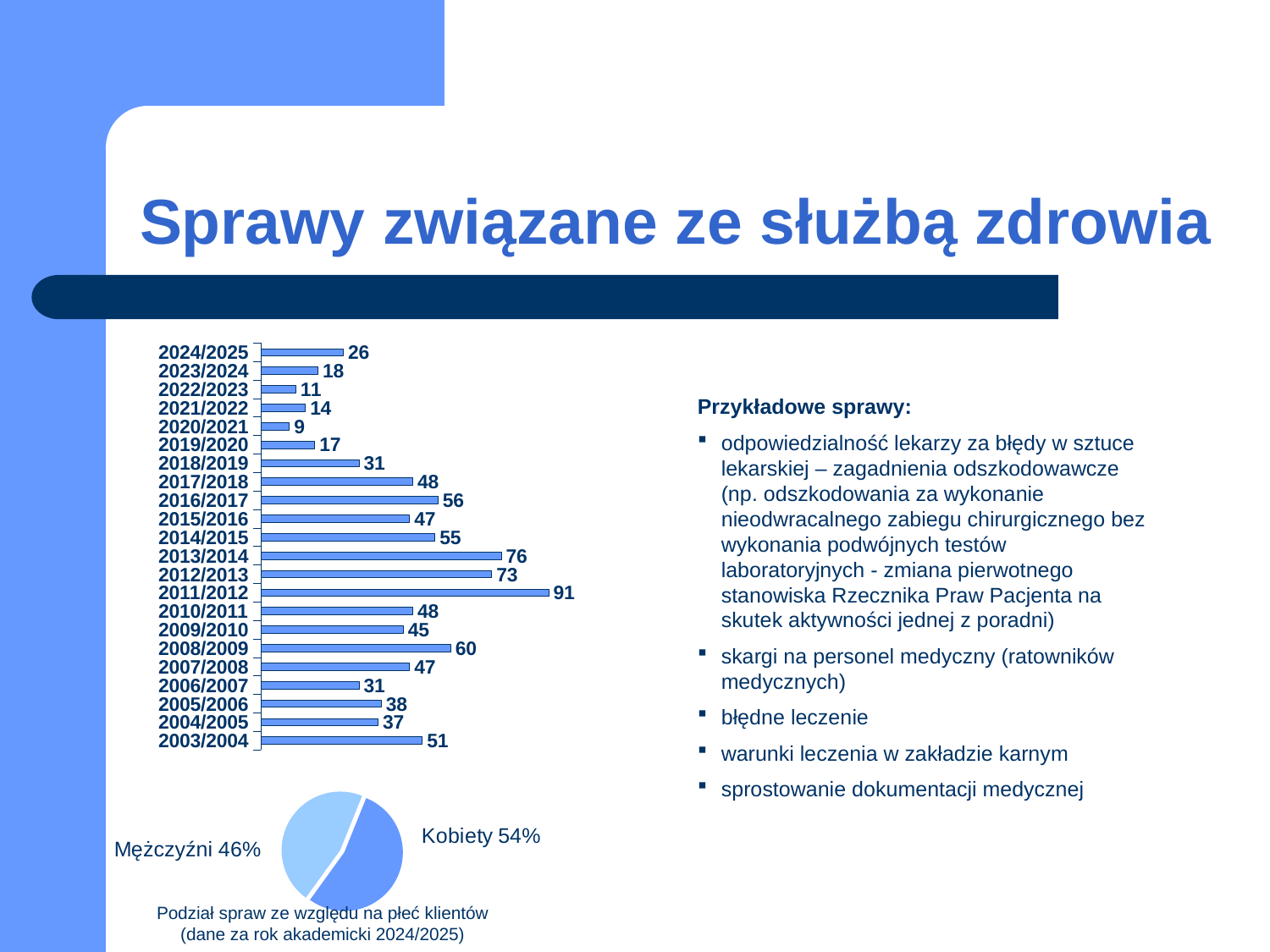
What type of chart shows the split of cases by client gender? pie chart In the bar chart, which is larger, the value for 2008/2009 or the value for 2016/2017? 2008/2009 In the bar chart, what is the difference between the values for 2013/2014 and 2012/2013? 3 How many academic years are shown in the bar chart? 22 In the bar chart, what is the value for 2011/2012? 91 In the bar chart, what is the value for 2020/2021? 9 In the bar chart, which academic year has the highest value? 2011/2012 In the pie chart, what share is labelled Mężczyźni? 46% In the bar chart, which academic year has the lowest value? 2020/2021 In the bar chart, what is the value for 2024/2025? 26 What type of chart is the chart showing values by academic year? bar chart In the pie chart, what share is labelled Kobiety? 54%